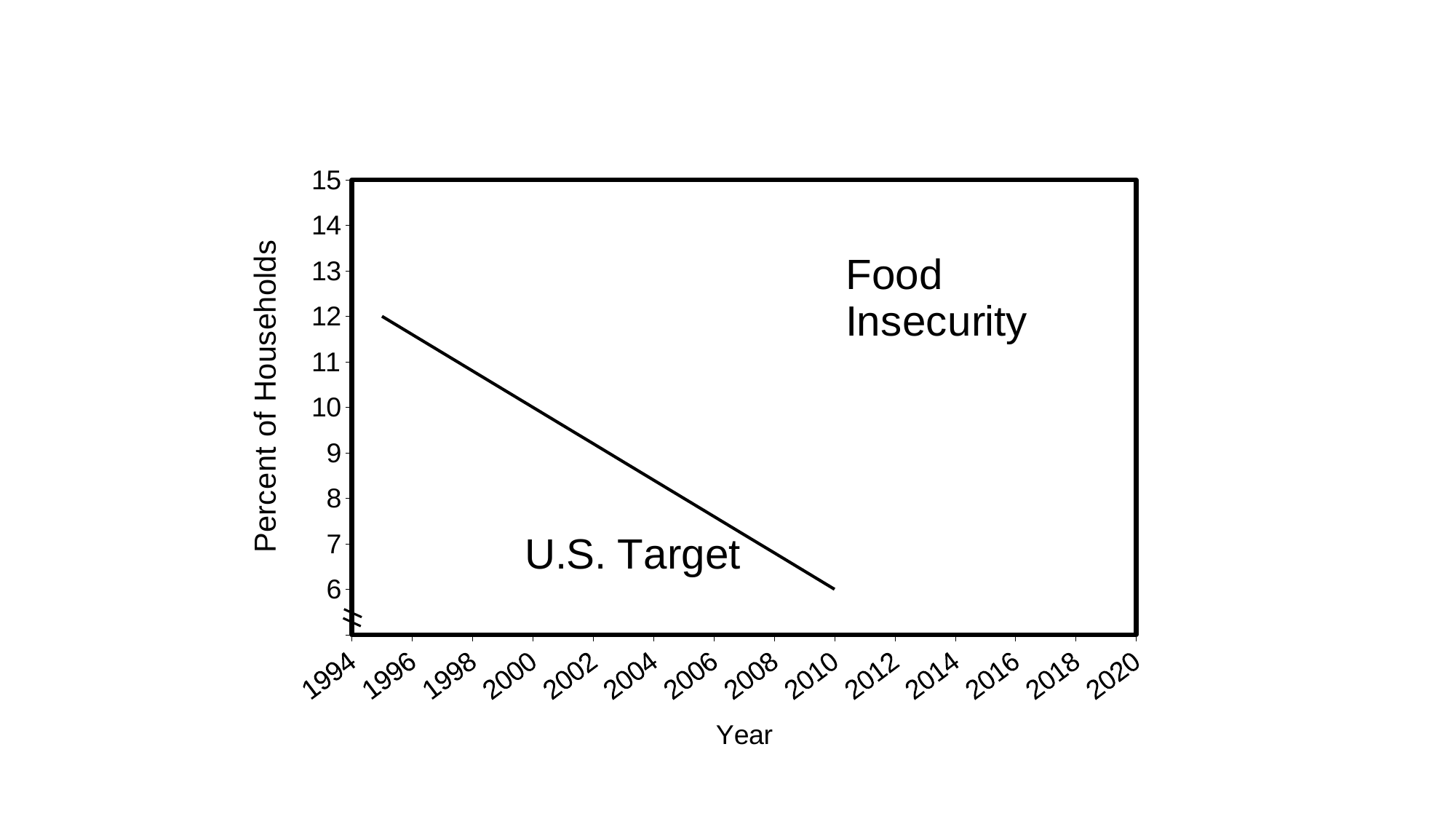
At what value does the U.S. Target line start at its left end? 12 What is the label of the vertical axis? Percent of Households Is the value of the U.S. Target line in 2000 greater or less than 9? greater What value does the U.S. Target line reach in 2010? 6 What is the label of the horizontal axis? Year Is the value of the U.S. Target line in 2006 greater or less than 7? greater In which year does the U.S. Target line end? 2010 Which is higher on the U.S. Target line: the value at its start or the value in 2010? the value at its start What kind of chart is shown on the slide? line chart Does the U.S. Target line rise or fall as the year increases? fall What is the difference between the starting value (12) and the 2010 value (6) of the U.S. Target line? 6 Is the value of the U.S. Target line in 2002 greater or less than 10? less